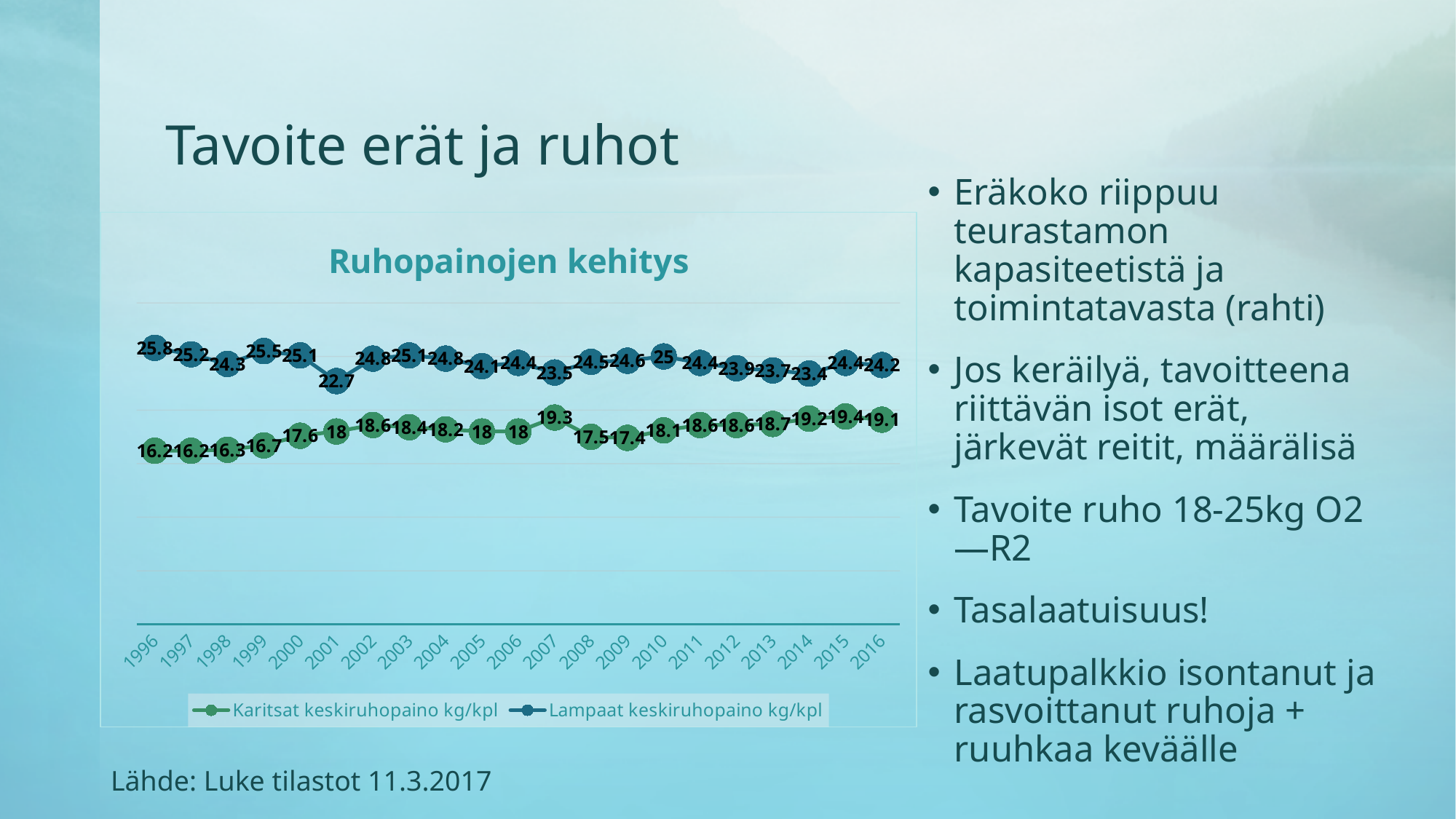
What kind of chart is shown on the slide? Line chart How many years are plotted along the x axis of the chart? 21 In which year is the Lampaat keskiruhopaino kg/kpl value lowest? 2001 In which year is the Lampaat keskiruhopaino kg/kpl value highest? 1996 How many series does the chart legend list? 2 What is the difference between the Lampaat and Karitsat keskiruhopaino values in 2016? 5.1 What is the title of the chart? Ruhopainojen kehitys In which year is the Karitsat keskiruhopaino kg/kpl value highest? 2015 What is the value for Karitsat keskiruhopaino kg/kpl in 2007? 19.3 Does the Karitsat keskiruhopaino kg/kpl series rise or fall overall from 1996 to 2016? Rise Which is larger for Karitsat keskiruhopaino kg/kpl: the value in 2000 or the value in 2001? 2001 What is the value for Lampaat keskiruhopaino kg/kpl in 2001? 22.7